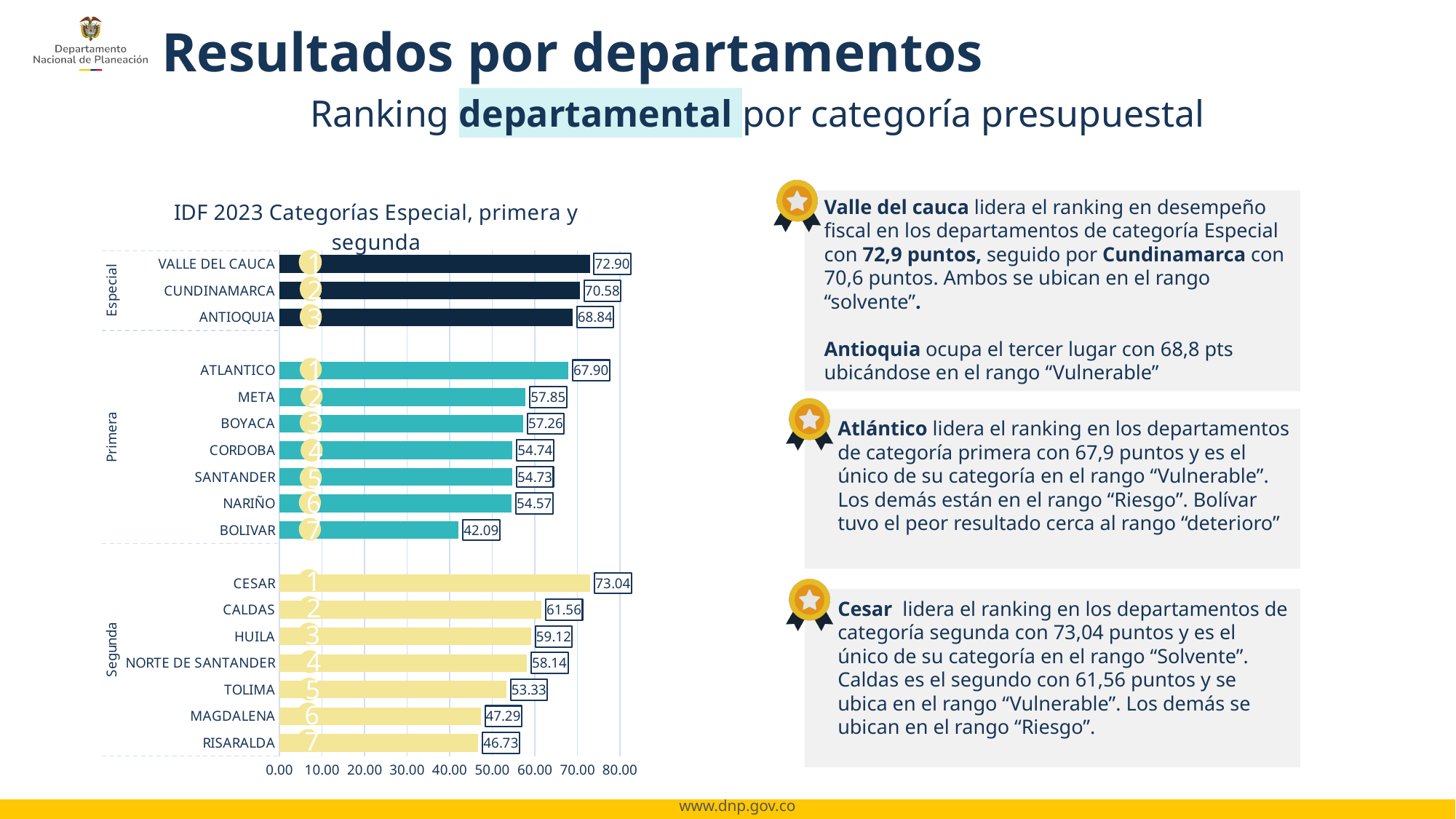
What kind of chart is shown on the slide? bar chart What is the value for BOLIVAR in the IDF 2023 chart? 42.09 What is the difference between the values for VALLE DEL CAUCA and CUNDINAMARCA? 2.32 Which department has the highest value in the IDF 2023 chart? CESAR What is the value for NORTE DE SANTANDER in the IDF 2023 chart? 58.14 Which has a larger value, ATLANTICO or ANTIOQUIA? ANTIOQUIA Is the value for TOLIMA greater or less than 50.00? greater What is the value for VALLE DEL CAUCA in the IDF 2023 chart? 72.90 How many departments are shown in the IDF 2023 chart? 17 Which department has the lowest value in the IDF 2023 chart? BOLIVAR What is the title of the chart on the slide? IDF 2023 Categorías Especial, primera y segunda What is the difference between the values for CESAR and CALDAS? 11.48